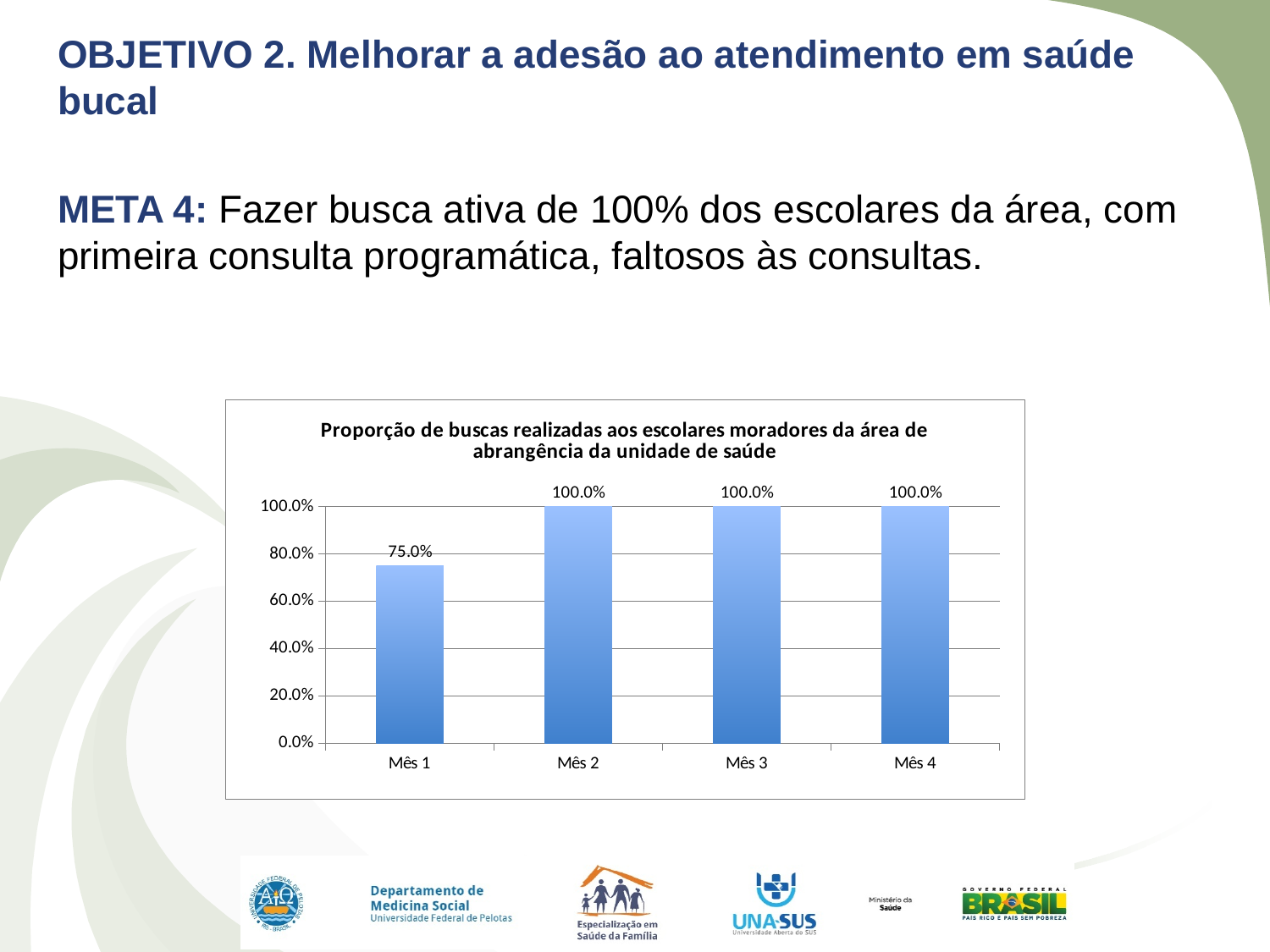
How many months have a value of 100.0%? 3 Which month has the lowest value? Mês 1 Which is larger, the value for Mês 1 or the value for Mês 4? Mês 4 What kind of chart is shown on the slide? bar chart How many months are shown on the x axis? 4 Is the value for Mês 1 greater or less than 80.0%? less Do the values rise or fall from Mês 1 to Mês 2? rise What is the title of the chart? Proporção de buscas realizadas aos escolares moradores da área de abrangência da unidade de saúde What is the difference between the values for Mês 2 and Mês 1? 25.0% What is the value for Mês 3? 100.0% What is the value for Mês 1? 75.0% What is the highest value shown on the y axis? 100.0%